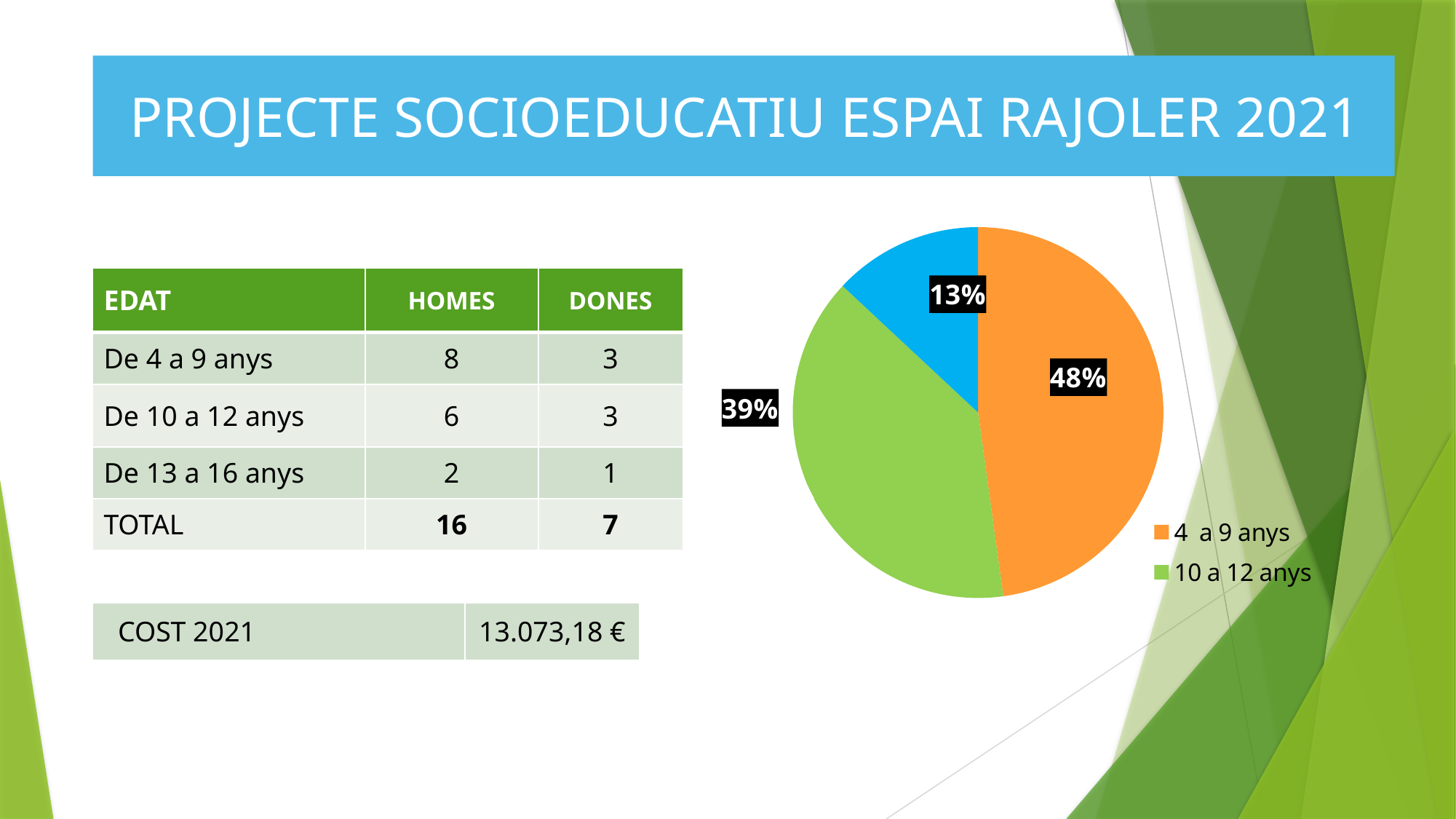
What share of the pie chart does the "10 a 12 anys" slice represent? 39% How many slices does the pie chart have? 3 What is the difference in percentage points between the "4 a 9 anys" slice and the "10 a 12 anys" slice? 9 Which category has the largest slice in the pie chart? 4 a 9 anys What kind of chart is shown on the slide? pie chart What colour is the "10 a 12 anys" slice in the pie chart? green Is the share for "4 a 9 anys" greater or less than 50%? less What is the largest percentage label shown on the pie chart? 48% What is the smallest percentage shown on the pie chart? 13% What colour is the "4 a 9 anys" slice in the pie chart? orange Which slice is larger, "4 a 9 anys" or "10 a 12 anys"? 4 a 9 anys What share of the pie chart does the "4 a 9 anys" slice represent? 48%